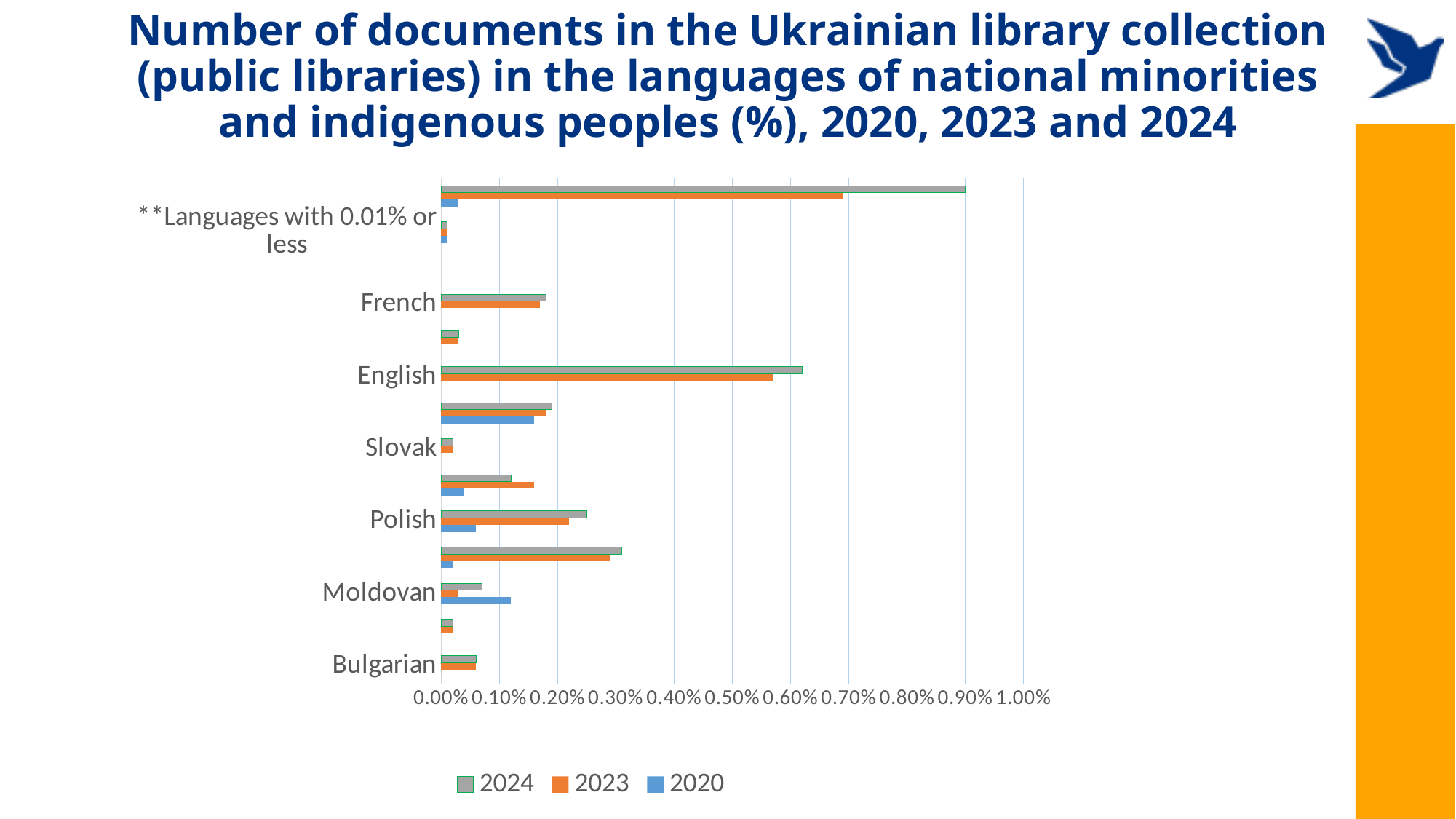
Is the 2023 value for English greater or less than 0.50%? greater Is the 2024 value for English greater or less than 0.50%? greater What kind of chart is shown on the slide? bar chart Is the 2024 value for French greater or less than 0.10%? greater How many series does the legend list? 3 What colour represents the 2023 series? orange Which has the larger 2024 value, English or French? English Which years are listed in the legend? 2024, 2023 and 2020 Which has the larger 2024 value, Polish or Bulgarian? Polish